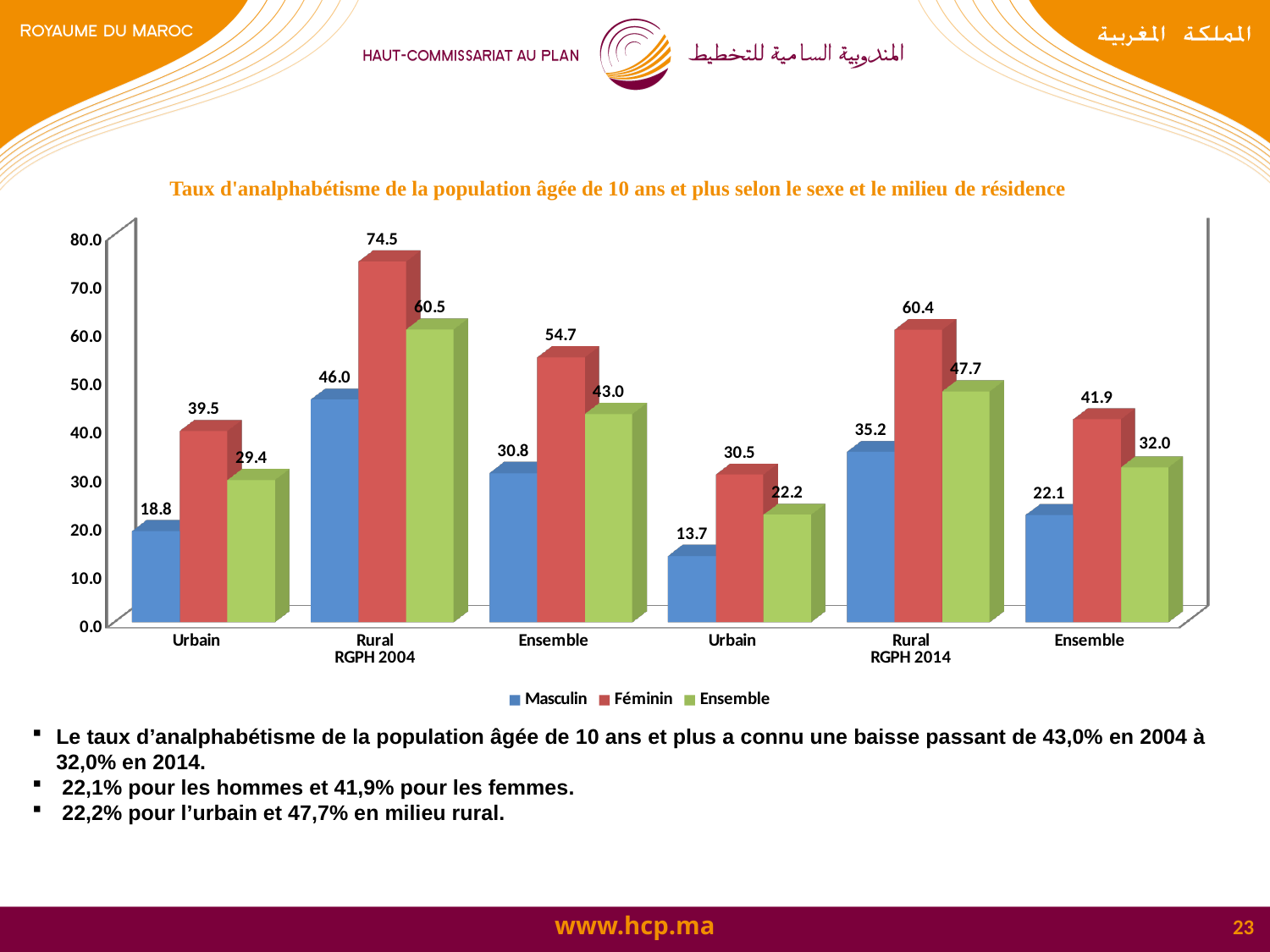
What is the difference between the Ensemble values for Ensemble in RGPH 2004 and RGPH 2014? 11.0 Which category and census has the lowest Masculin value? Urbain, RGPH 2014 How many category groups are shown on the x axis? 6 What kind of chart is shown? bar chart What is the Masculin value for Urbain in RGPH 2014? 13.7 What colour represents the Féminin series? red How many series does the legend list? 3 What is the Ensemble value for Ensemble in RGPH 2014? 32.0 Is the Féminin value for Urbain in RGPH 2014 greater or less than 40.0? less Which is larger: the Masculin value for Rural in RGPH 2004 or the Masculin value for Rural in RGPH 2014? Rural in RGPH 2004 Which category and census has the highest Féminin value? Rural, RGPH 2004 What is the Féminin value for Rural in RGPH 2004? 74.5